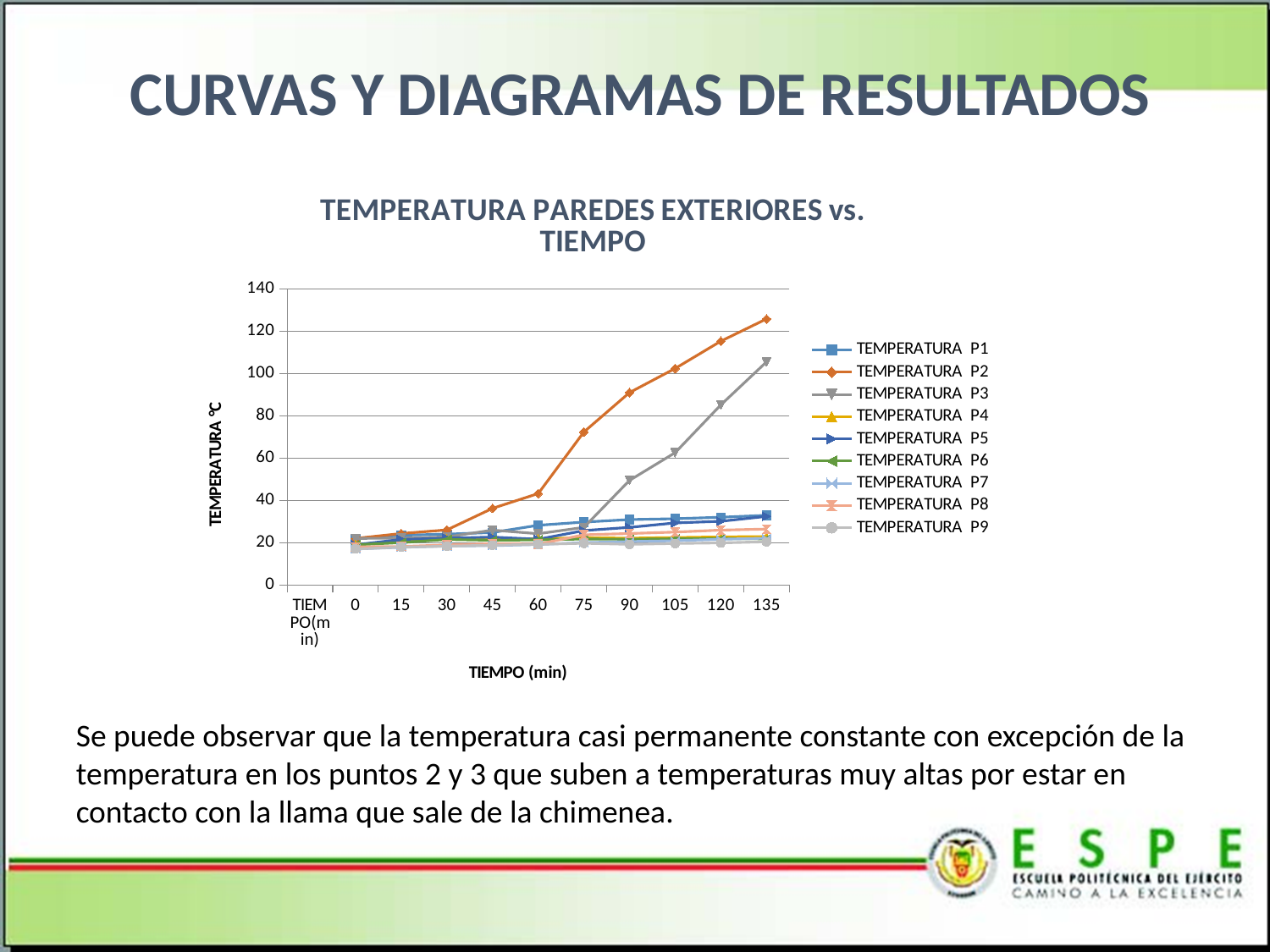
What is the title of the chart? TEMPERATURA PAREDES EXTERIORES vs. TIEMPO Which series reaches the highest temperature at 135 minutes? TEMPERATURA P2 How many series does the legend list? 9 At 135 minutes, which is larger: TEMPERATURA P2 or TEMPERATURA P3? TEMPERATURA P2 Is the value for TEMPERATURA P1 at 135 minutes greater or less than 40? less Is the value for TEMPERATURA P3 at 135 minutes greater or less than 100? greater Is the value for TEMPERATURA P2 at 90 minutes greater or less than 80? greater What kind of chart is shown on the slide? Line chart Does the TEMPERATURA P2 series rise or fall as time increases from 0 to 135 minutes? Rises What is the label of the vertical axis? TEMPERATURA °C